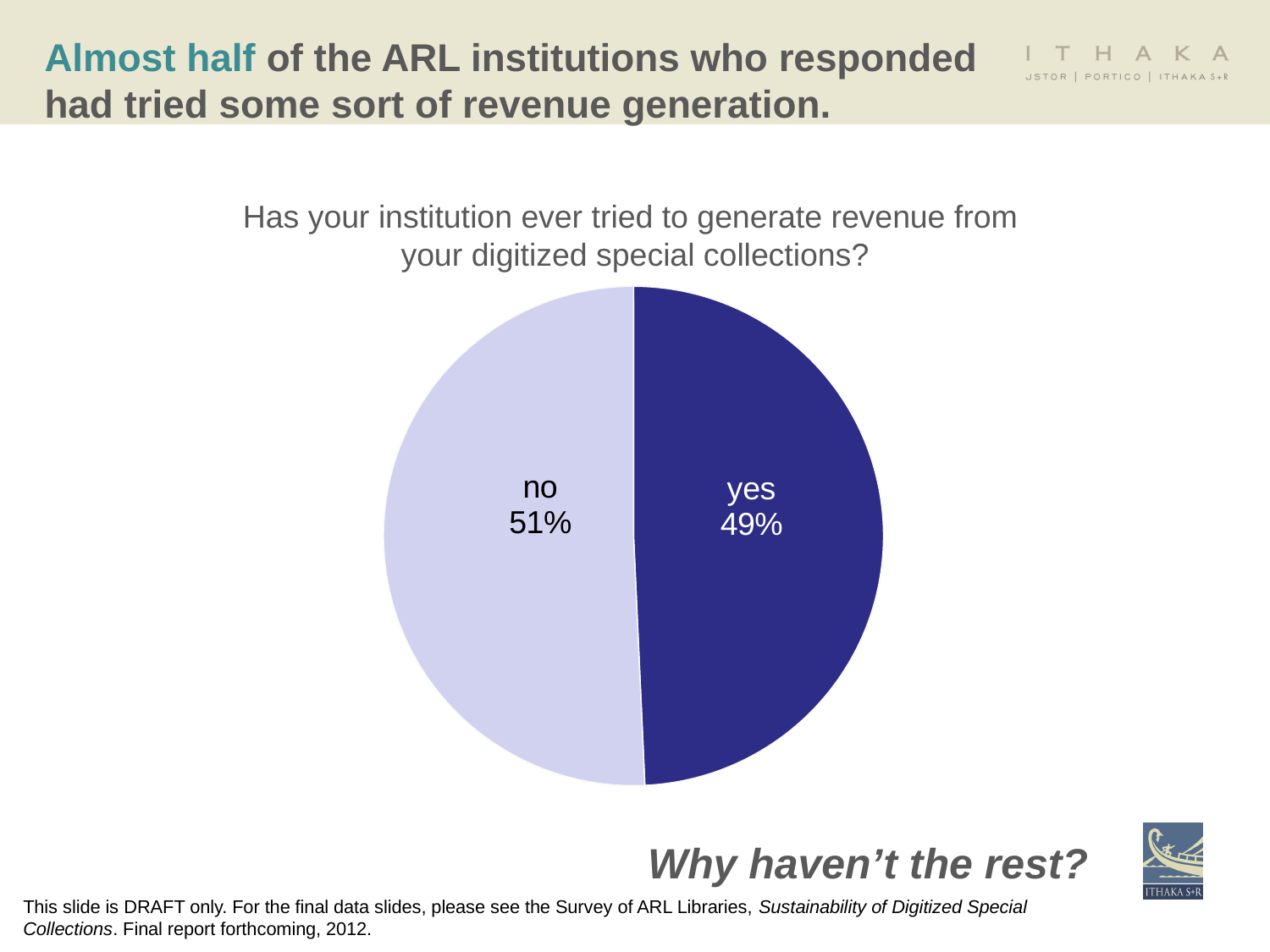
What share of the pie does the "yes" slice represent? 49% Which slice is coloured dark blue? yes Which is larger, the "yes" slice or the "no" slice? no Which slice of the pie is the smallest? yes Which slice of the pie is the largest? no What is the title of the pie chart? Has your institution ever tried to generate revenue from your digitized special collections? What type of chart is shown on the slide? pie chart What is the difference in percentage points between the "no" and "yes" slices? 2 What percentage of institutions answered "no"? 51% How many slices does the pie chart have? 2 What percentage of institutions answered "yes"? 49%